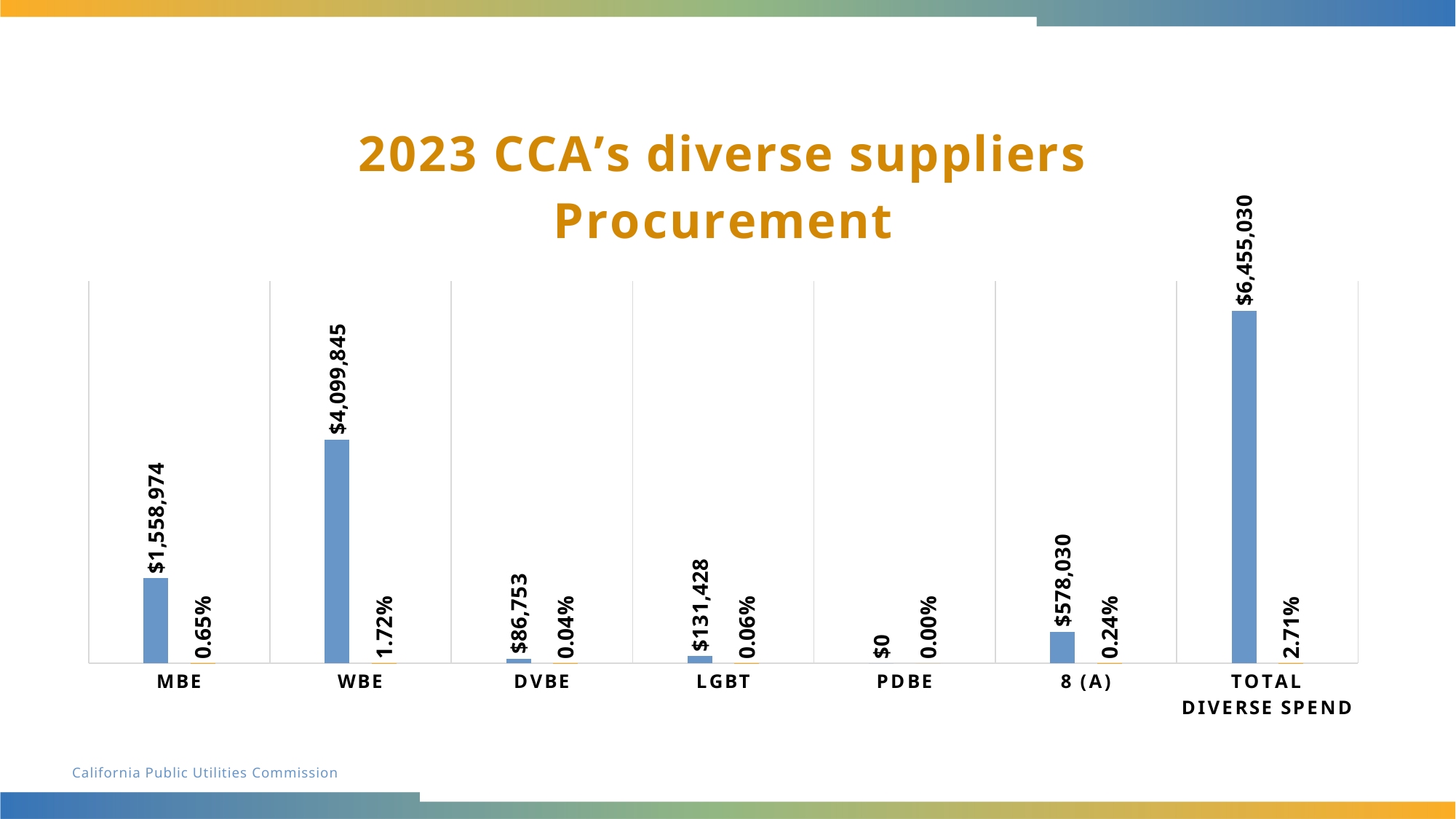
What is the dollar value shown for Total Diverse Spend? $6,455,030 What percentage is shown for 8 (A)? 0.24% Which individual supplier category (excluding Total Diverse Spend) has the highest dollar value? WBE Which has a larger dollar value, LGBT or DVBE? LGBT What is the difference in dollar value between WBE and MBE? $2,540,871 What type of chart is shown on the slide? Bar chart What percentage is shown for Total Diverse Spend? 2.71% How many categories are shown on the x axis? 7 What is the dollar value shown for MBE? $1,558,974 What is the dollar value shown for WBE? $4,099,845 Which category has the lowest dollar value? PDBE What is the difference in dollar value between LGBT and DVBE? $44,675